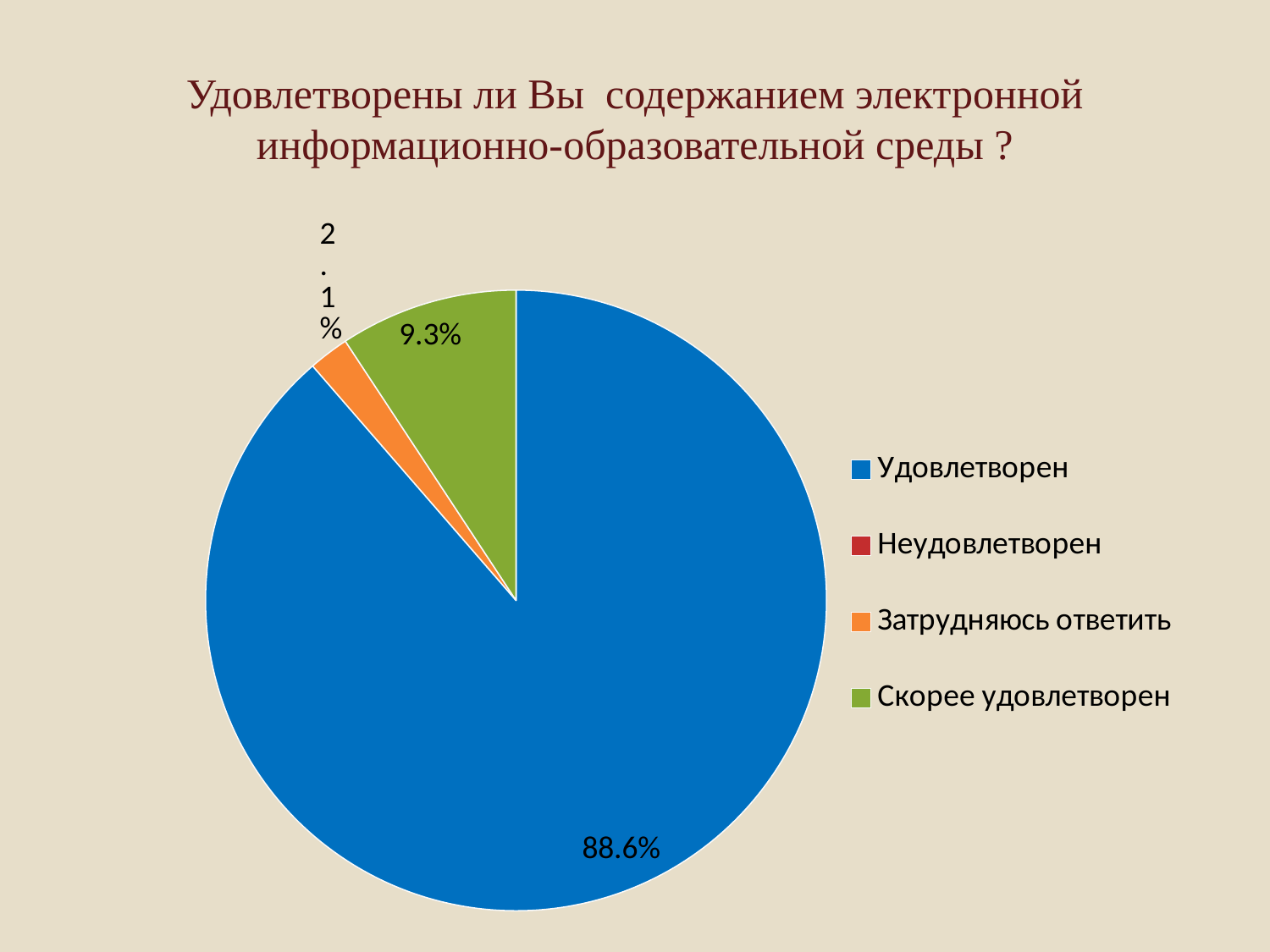
What colour represents "Скорее удовлетворен" in the pie chart? green Which legend entry is shown in orange? Затрудняюсь ответить What percentage of respondents answered "Удовлетворен"? 88.6% Which answer category has the largest share of the pie? Удовлетворен How many answer categories does the legend list? 4 What percentage of respondents answered "Скорее удовлетворен"? 9.3% What percentage of respondents answered "Затрудняюсь ответить"? 2.1% What is the difference in percentage points between "Удовлетворен" and "Скорее удовлетворен"? 79.3 Of the slices with a printed value, which has the smallest share? Затрудняюсь ответить What is the difference in percentage points between "Скорее удовлетворен" and "Затрудняюсь ответить"? 7.2 What kind of chart is shown on the slide? pie chart Which is larger: the share for "Скорее удовлетворен" or for "Затрудняюсь ответить"? Скорее удовлетворен